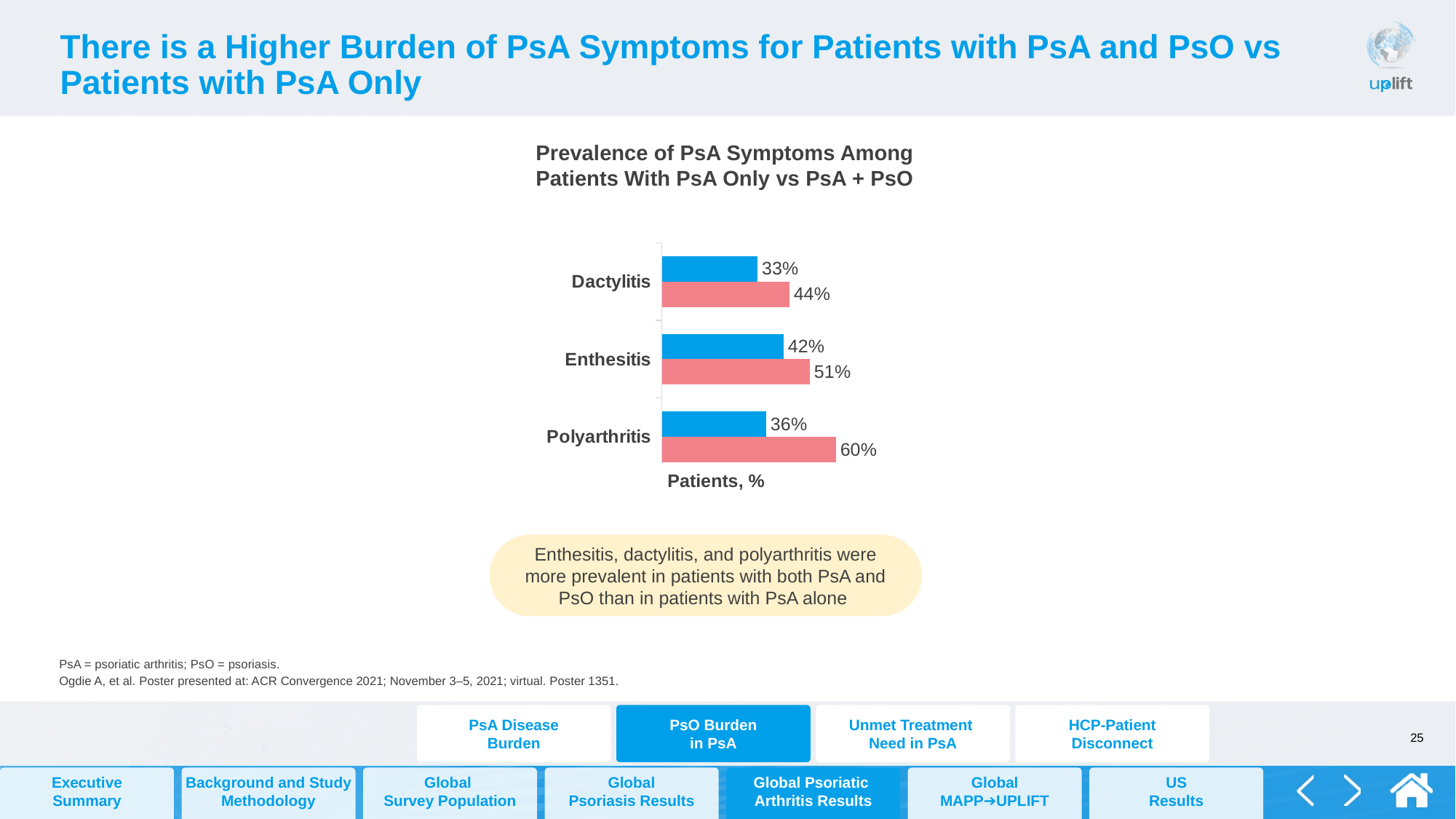
What is the value of the blue bar for Polyarthritis? 36% How many symptom categories are shown in the chart? 3 What type of chart is shown on the slide? Bar chart What is the value of the pink bar for Polyarthritis? 60% What is the difference between the pink and blue bars for Dactylitis? 11% What is the value of the blue bar for Dactylitis? 33% Which symptom has the highest value among the pink bars? Polyarthritis Which symptom has the highest value among the blue bars? Enthesitis Which symptom has the lowest value among the blue bars? Dactylitis What is the value of the pink bar for Enthesitis? 51% For Enthesitis, which bar is larger, the blue bar or the pink bar? The pink bar (51%) What is the difference between the pink and blue bars for Polyarthritis? 24%